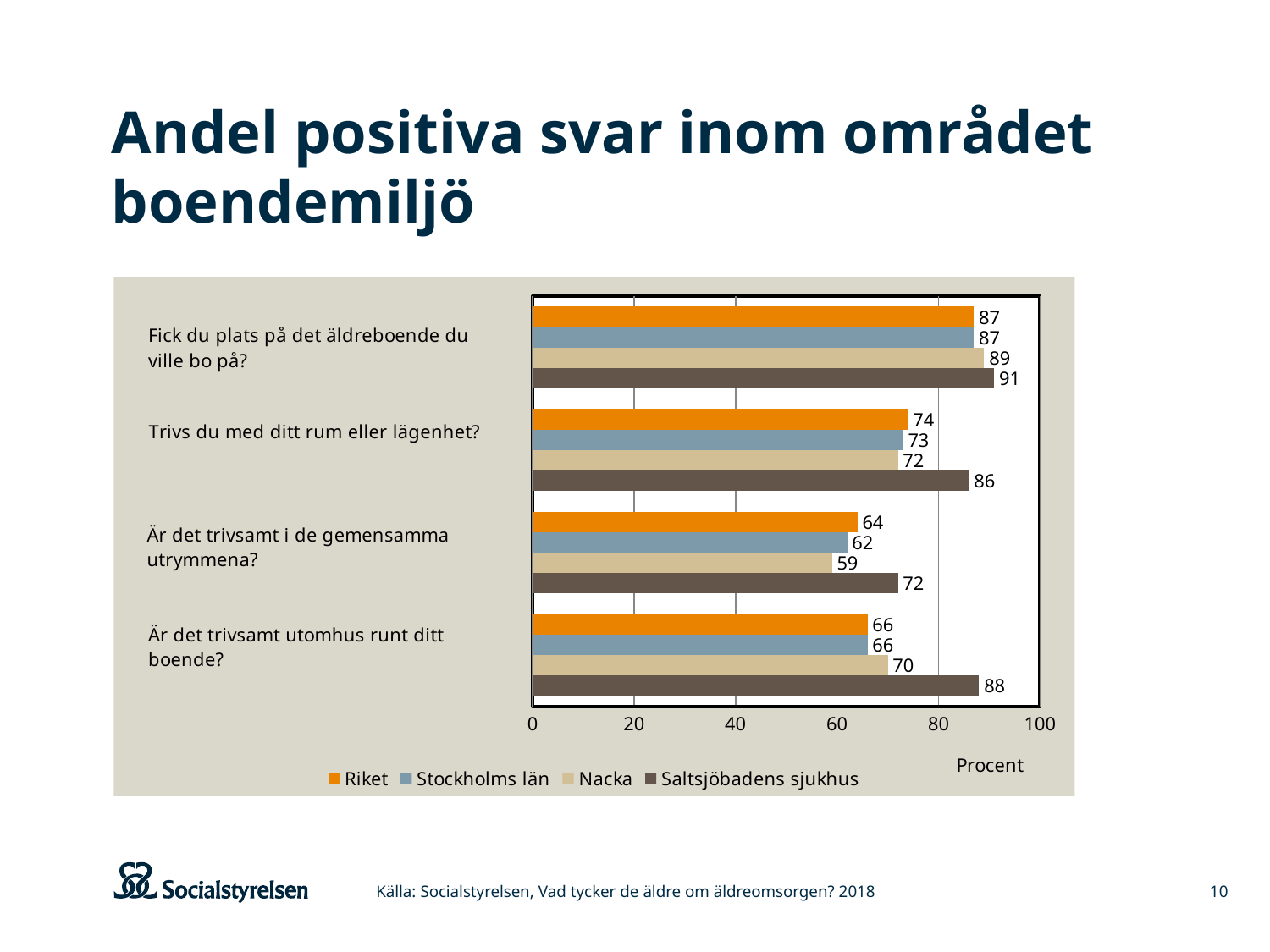
How many questions (categories) are shown on the chart? 4 Which series has the lowest value on "Är det trivsamt i de gemensamma utrymmena?"? Nacka What unit is shown on the horizontal axis of the chart? Procent How many series does the legend list? 4 What is the value for Nacka on "Är det trivsamt i de gemensamma utrymmena?"? 59 What is the value for Riket on "Är det trivsamt utomhus runt ditt boende?"? 66 Which is larger on "Trivs du med ditt rum eller lägenhet?": Riket or Nacka? Riket What is the difference between Saltsjöbadens sjukhus and Riket on "Är det trivsamt utomhus runt ditt boende?"? 22 Is the value for Stockholms län on "Är det trivsamt i de gemensamma utrymmena?" greater or less than 60? greater What kind of chart is shown on the slide? Bar chart Which series has the highest value on "Fick du plats på det äldreboende du ville bo på?"? Saltsjöbadens sjukhus What is the value for Saltsjöbadens sjukhus on "Trivs du med ditt rum eller lägenhet?"? 86